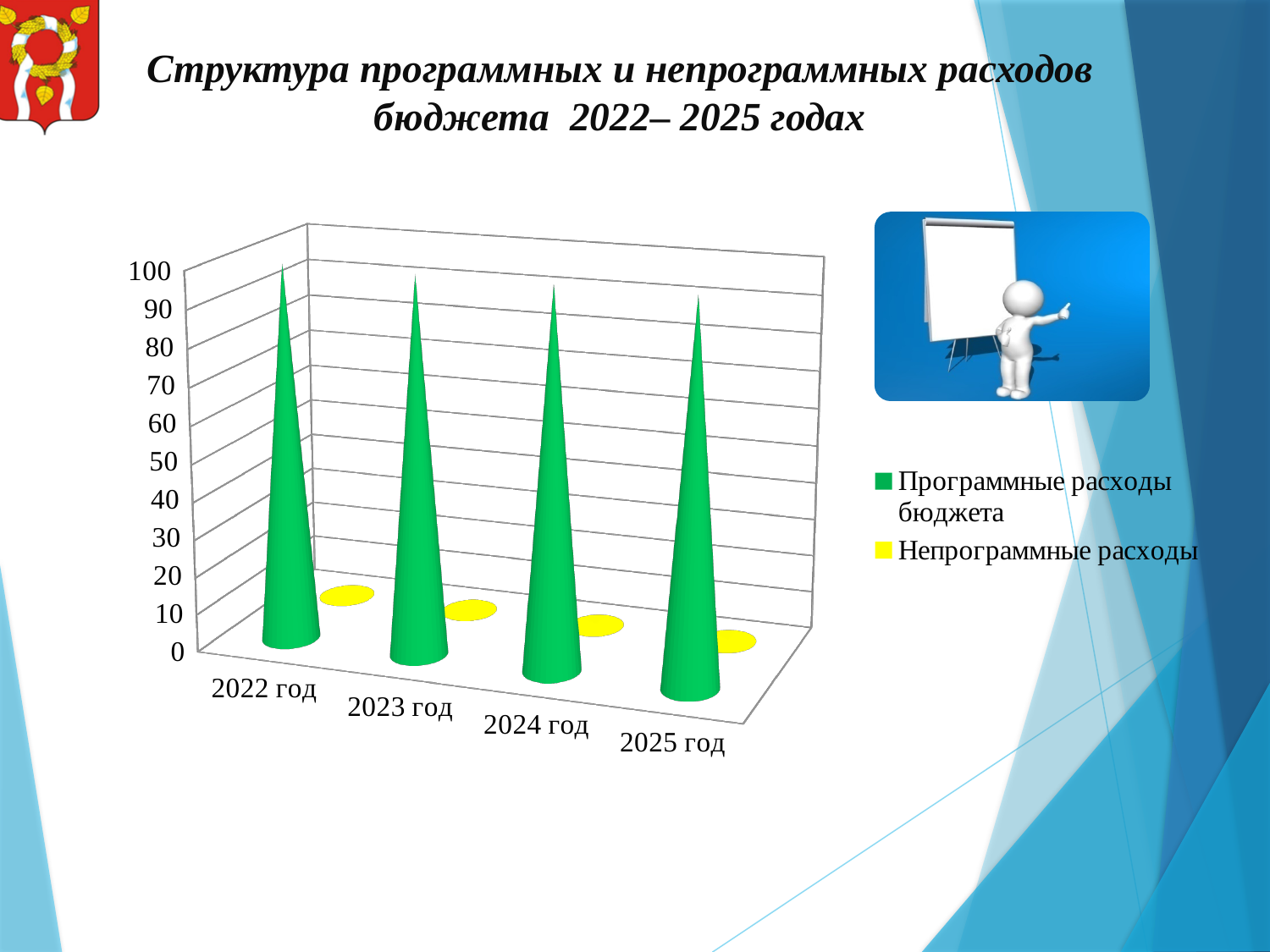
Which series has the highest values across all years in the chart? Программные расходы бюджета What kind of chart is shown on the slide? bar chart How many years (categories) are shown on the x axis of the chart? 4 Which series has the lowest values across all years in the chart? Непрограммные расходы Is the value for Программные расходы бюджета in 2022 год greater or less than 50? greater How many series does the chart legend list? 2 What colour represents Непрограммные расходы in the chart? yellow Is the value for Непрограммные расходы in 2025 год greater or less than 20? less Is the value for Непрограммные расходы in 2022 год greater or less than 10? less What is the first year shown on the x axis of the chart? 2022 год In 2023 год, which is larger: Программные расходы бюджета or Непрограммные расходы? Программные расходы бюджета